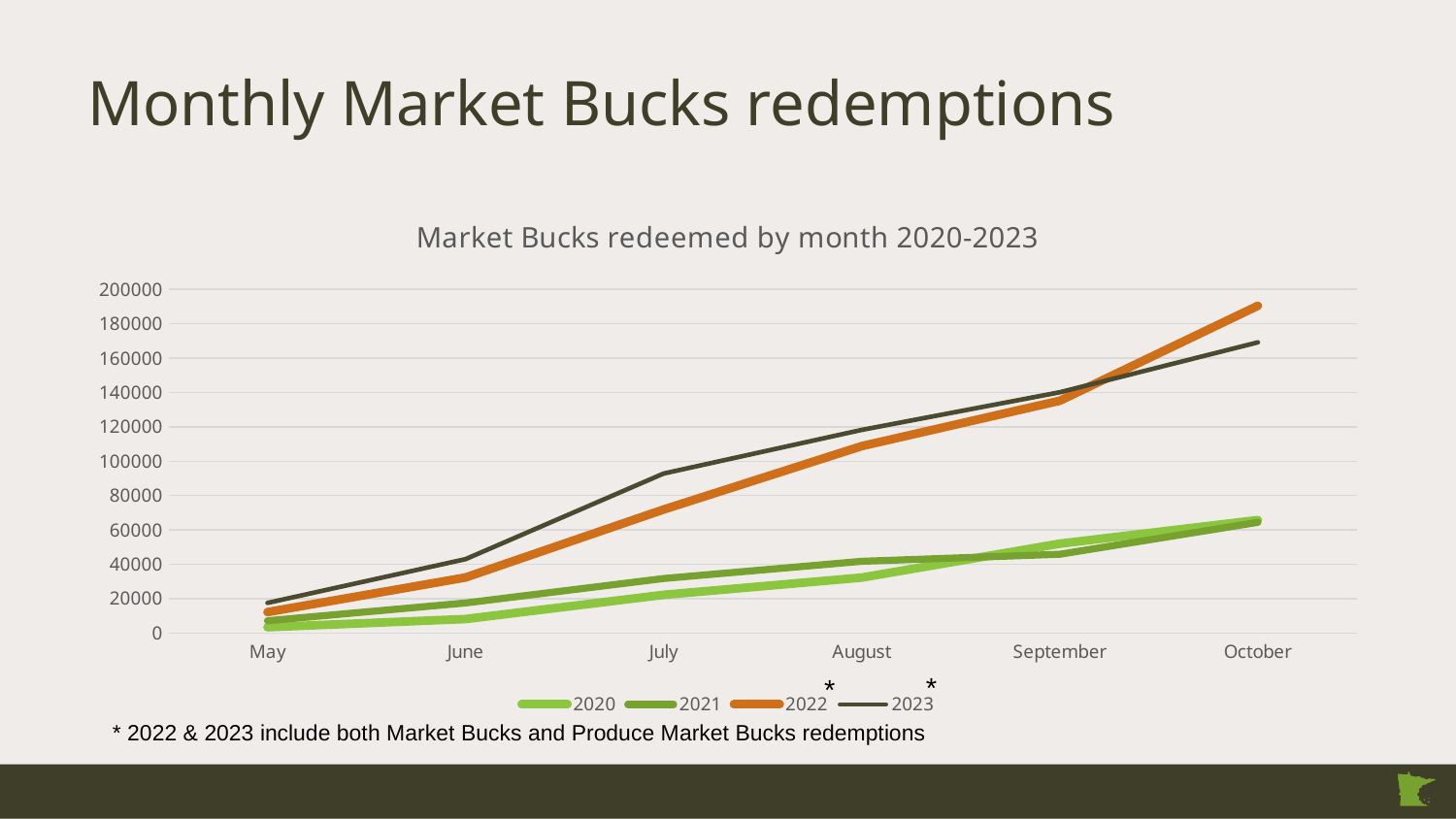
Is the value for 2022 in October greater or less than 180000? greater What is the title of the chart? Market Bucks redeemed by month 2020-2023 How many series does the legend list? 4 Do the values for 2022 rise or fall from May to October? rise Is the value for 2023 in October greater or less than 180000? less In July, which is larger, the value for 2022 or the value for 2023? 2023 Which year has the highest value in October? 2022 What kind of chart is shown on the slide? line chart Is the value for 2020 in August greater or less than 40000? less How many months are shown along the x axis? 6 Which year has the lowest value in May? 2020